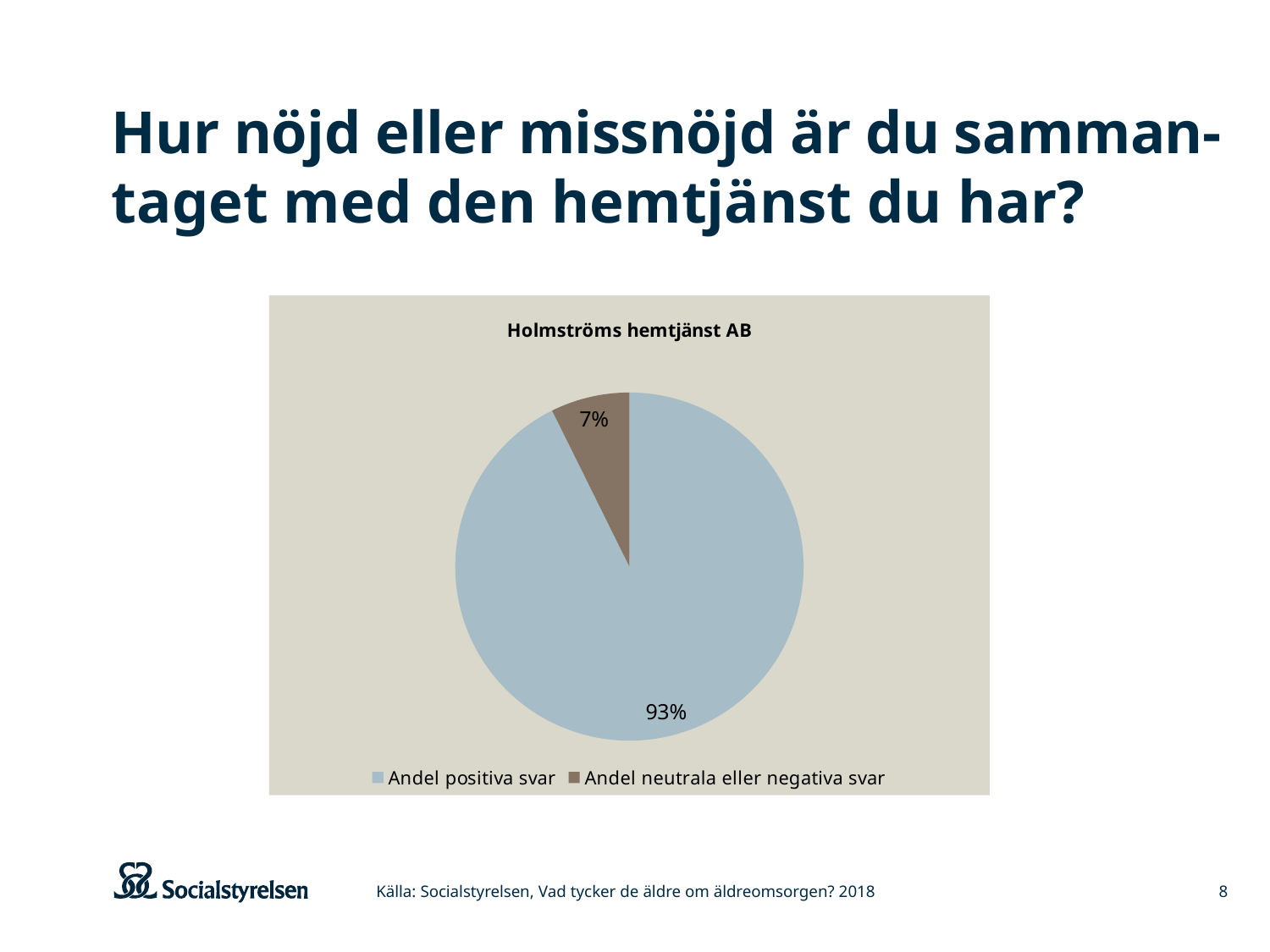
What is the difference in percentage points between 'Andel positiva svar' and 'Andel neutrala eller negativa svar'? 86 Which slice is the largest? Andel positiva svar What kind of chart is shown on the slide? pie chart How many slices does the pie chart have? 2 What share of the pie is 'Andel neutrala eller negativa svar'? 7% Which is larger, 'Andel positiva svar' or 'Andel neutrala eller negativa svar'? Andel positiva svar What is the chart's title? Holmströms hemtjänst AB Which slice is the smallest? Andel neutrala eller negativa svar What share of the pie is 'Andel positiva svar'? 93% What colour is the slice for 'Andel neutrala eller negativa svar'? brown How many entries does the legend list? 2